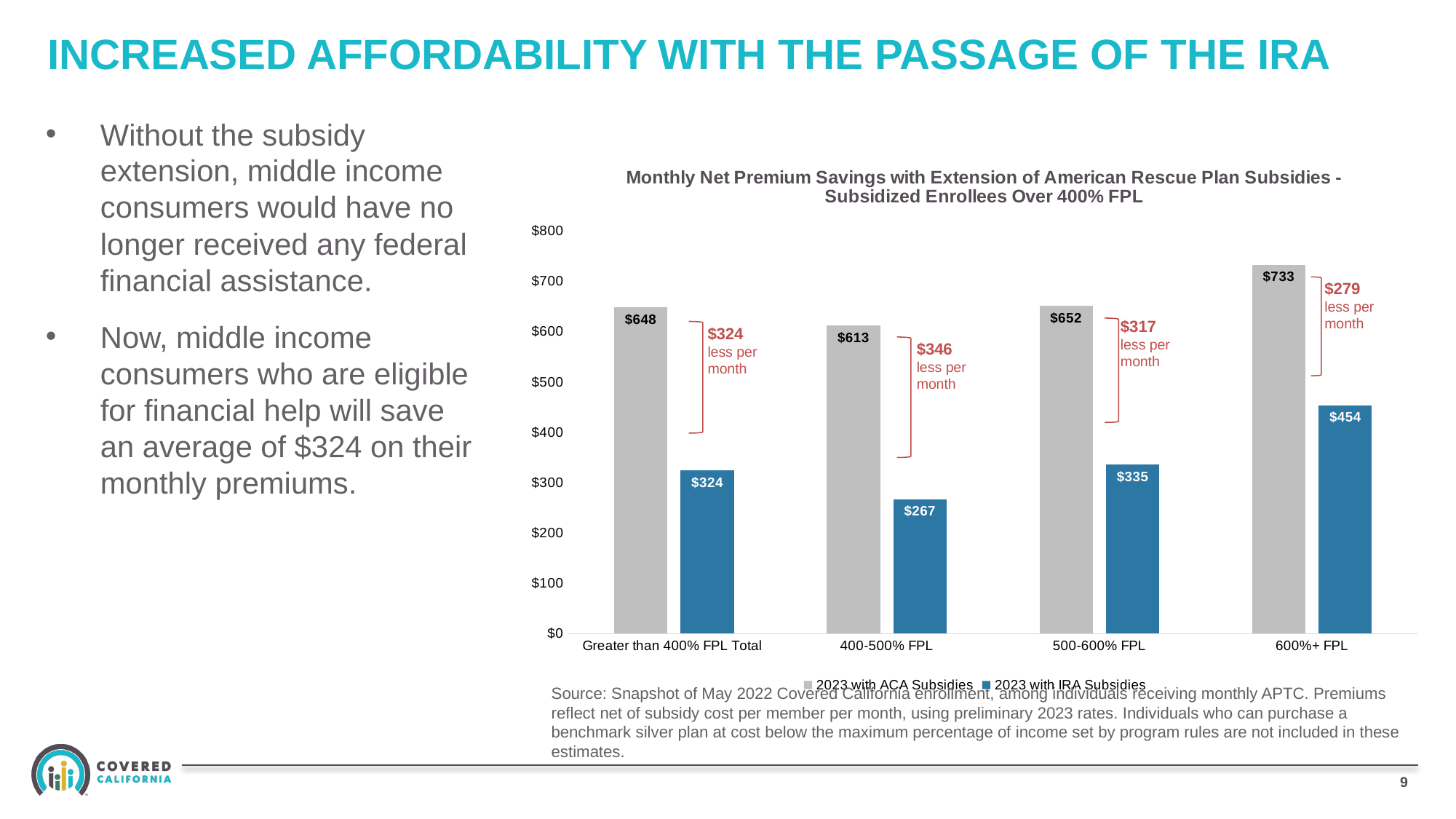
Which category has the highest value for 2023 with IRA Subsidies? 600%+ FPL What is the value for 2023 with ACA Subsidies in the 500-600% FPL category? $652 Is the value for 2023 with IRA Subsidies in the 600%+ FPL category greater or less than $400? greater What kind of chart is shown on the slide? Bar chart What is the value for 2023 with ACA Subsidies in the 600%+ FPL category? $733 How many series does the legend list? 2 How many categories are shown on the x axis? 4 What is the value for 2023 with IRA Subsidies in the 400-500% FPL category? $267 Which is larger: the 2023 with IRA Subsidies value for 500-600% FPL or for Greater than 400% FPL Total? 500-600% FPL Which category has the lowest value for 2023 with ACA Subsidies? 400-500% FPL What is the difference between the 2023 with ACA Subsidies and 2023 with IRA Subsidies values for the 500-600% FPL category? $317 What is the monthly savings annotated for the 400-500% FPL category? $346 less per month